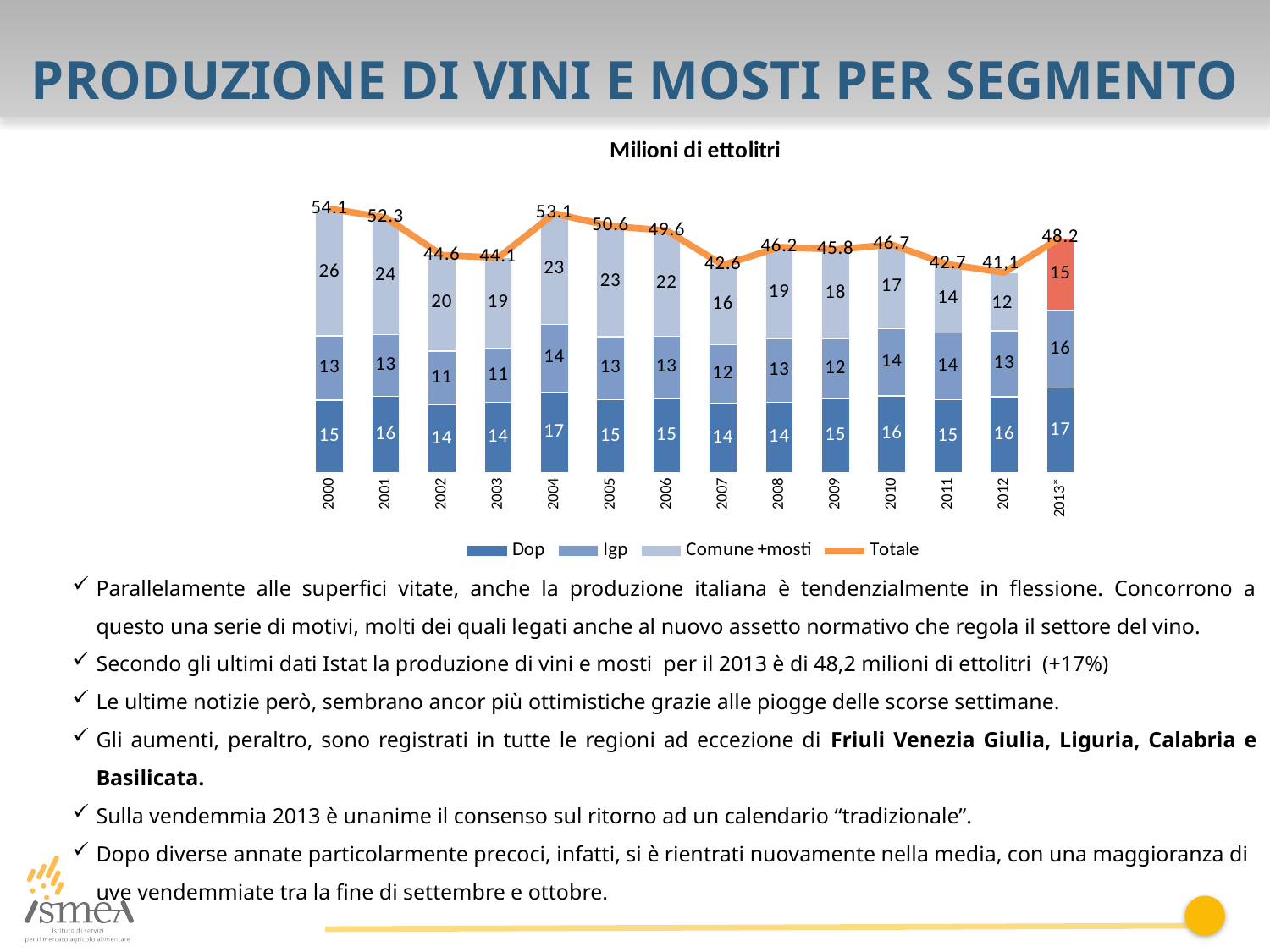
In which year is the Totale value lowest? 2012 What is the difference between the Comune +mosti values for 2000 and 2012? 14 What is the Igp value for 2013*? 16 What is the Dop value for 2004? 17 In which year is the Totale value highest? 2000 Does the Totale value rise or fall from 2000 to 2003? Fall What is the Totale value for 2000? 54.1 Which year has the larger Igp value, 2000 or 2013*? 2013* What is the Comune +mosti value for 2012? 12 How many years are shown on the x axis? 14 How many series does the legend list? 4 What kind of chart is shown on the slide? Stacked bar chart with a line